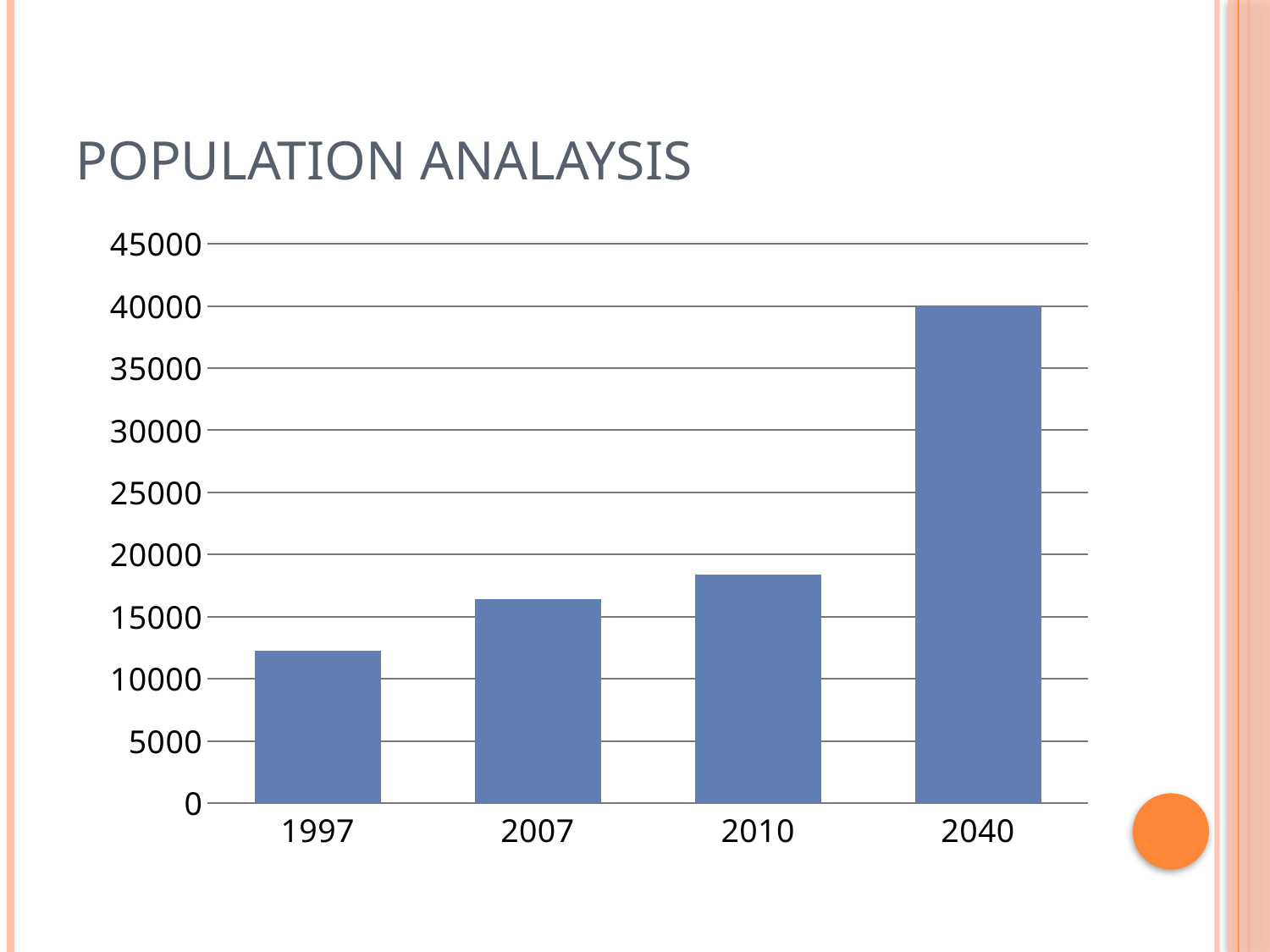
Is the value for 2007 greater or less than 15000? greater Which year has the highest value in the chart? 2040 Do the values rise or fall from 1997 to 2040 along the x axis? rise Is the value for 2010 greater or less than 20000? less What kind of chart is shown on the slide? bar chart What is the title of the chart? POPULATION ANALAYSIS What is the value for 2040? 40000 Which has the larger value, 2007 or 2010? 2010 Is the value for 1997 greater or less than 15000? less Which year has the lowest value in the chart? 1997 How many years are shown on the x axis of the chart? 4